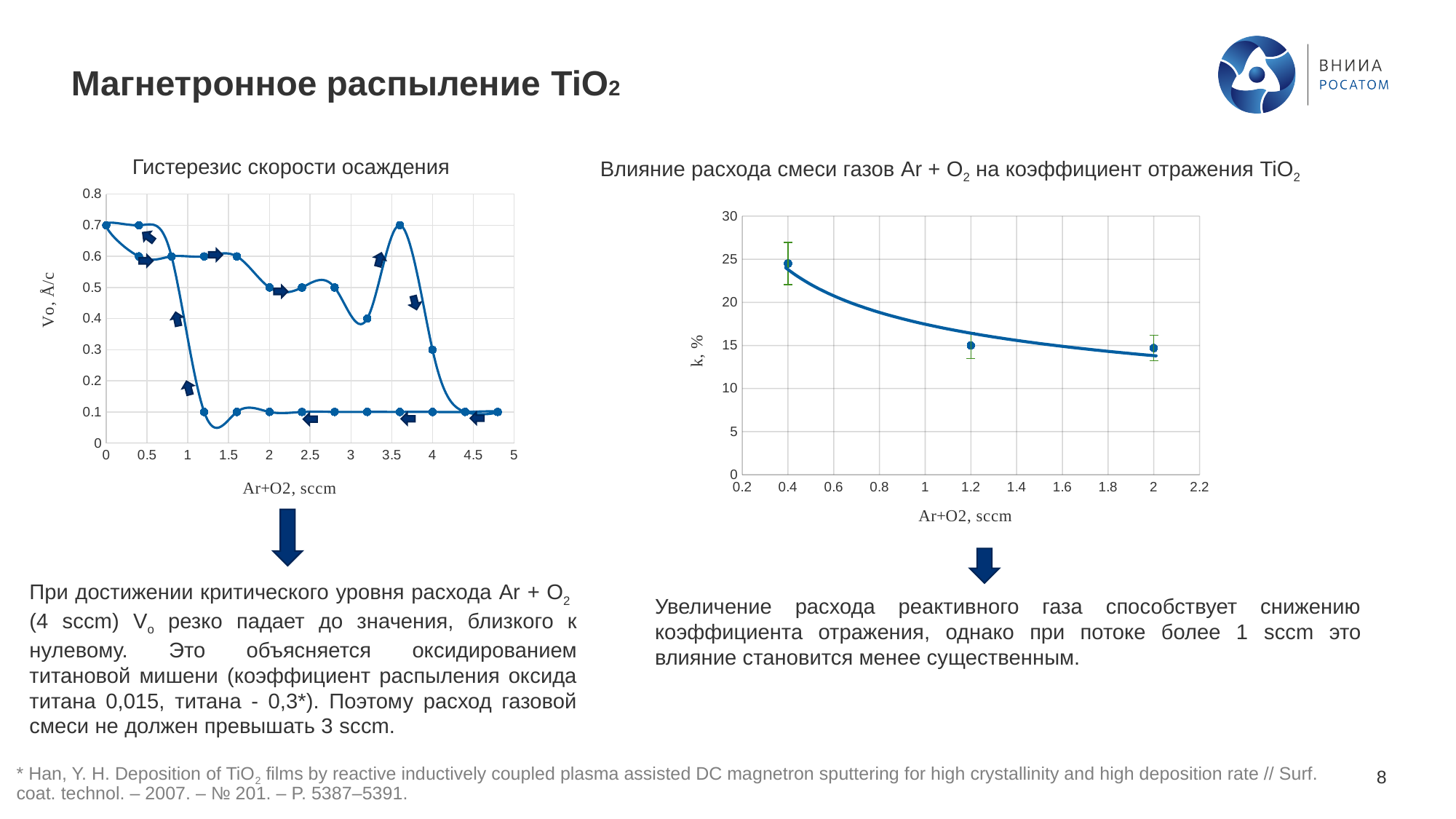
In the chart on the right (Влияние расхода смеси газов Ar + O2 на коэффициент отражения TiO2), at which Ar+O2 flow is k highest? 0.4 What kind of chart is the chart titled "Гистерезис скорости осаждения"? line chart In the chart on the right (Влияние расхода смеси газов Ar + O2 на коэффициент отражения TiO2), what is the value of k at Ar+O2 = 1.2 sccm? 15 In the chart on the right (Влияние расхода смеси газов Ar + O2 на коэффициент отражения TiO2), does k rise or fall as Ar+O2 flow increases? fall In the chart on the right (Влияние расхода смеси газов Ar + O2 на коэффициент отражения TiO2), is the value of k at Ar+O2 = 0.4 sccm greater or less than 20? greater In the chart titled "Гистерезис скорости осаждения", what is the x-axis title? Ar+O2, sccm In the chart on the right (Влияние расхода смеси газов Ar + O2 на коэффициент отражения TiO2), how many data points are plotted? 3 In the chart on the right (Влияние расхода смеси газов Ar + O2 на коэффициент отражения TiO2), is the value of k at Ar+O2 = 2 sccm greater or less than 20? less In the chart titled "Гистерезис скорости осаждения", what is the value of Vo at Ar+O2 = 0 sccm? 0.7 In the chart on the right (Влияние расхода смеси газов Ar + O2 на коэффициент отражения TiO2), which is larger: k at 0.4 sccm or k at 1.2 sccm? k at 0.4 sccm In the chart titled "Гистерезис скорости осаждения", what is the y-axis title? Vo, Å/c In the chart titled "Гистерезис скорости осаждения", what is the value of Vo at Ar+O2 = 4.8 sccm? 0.1